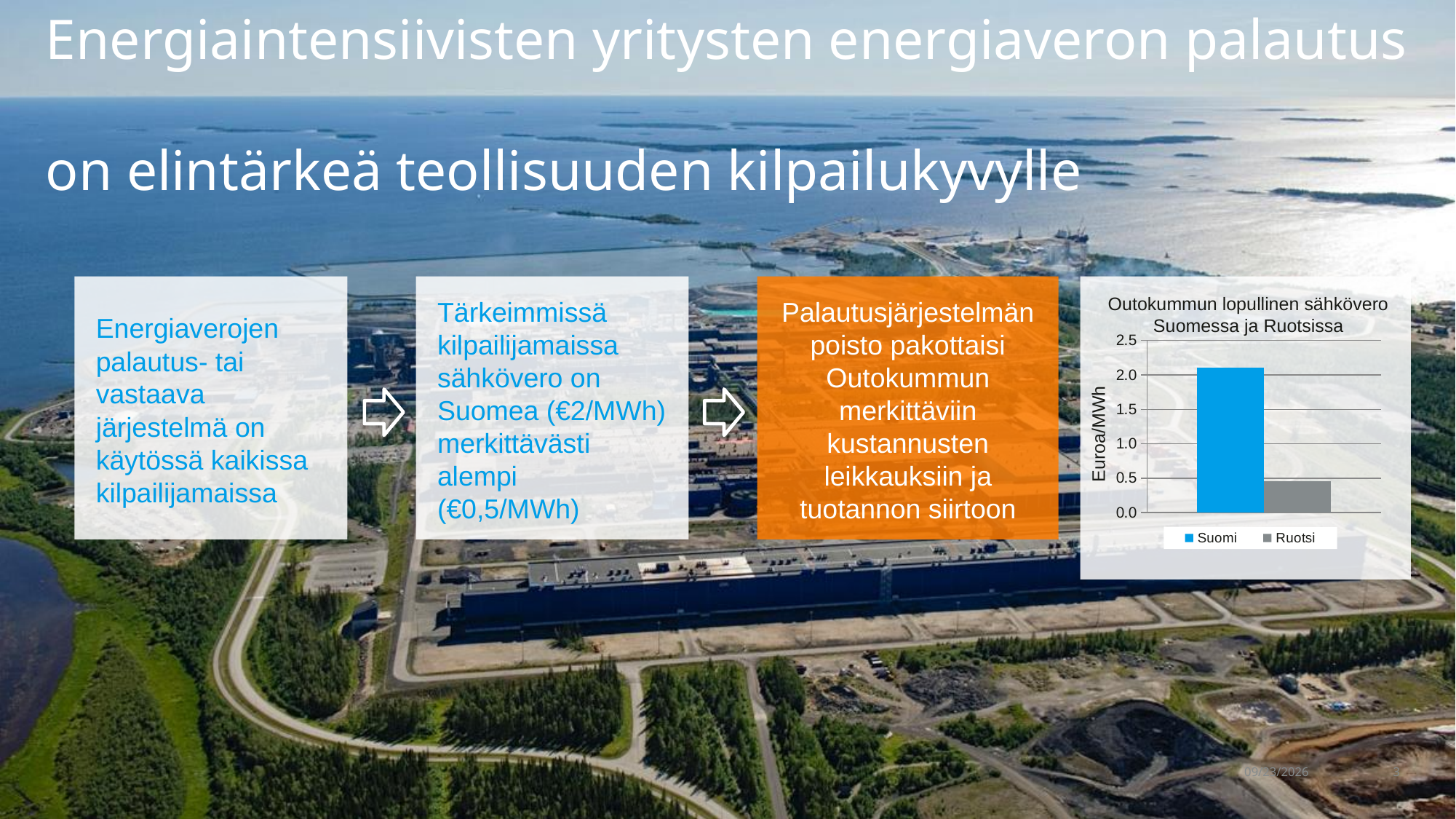
Which series has the highest value in the chart? Suomi How many series does the chart legend list? 2 What is the label of the vertical axis of the chart? Euroa/MWh Which series has the lowest value in the chart? Ruotsi Is the value for Ruotsi greater or less than 1.0? less How many bars are plotted in the chart? 2 Which is larger, the value for Suomi or the value for Ruotsi? Suomi Is the value for Suomi greater or less than 1.5? greater What kind of chart is shown on the slide? bar chart What is the title of the chart? Outokummun lopullinen sähkövero Suomessa ja Ruotsissa